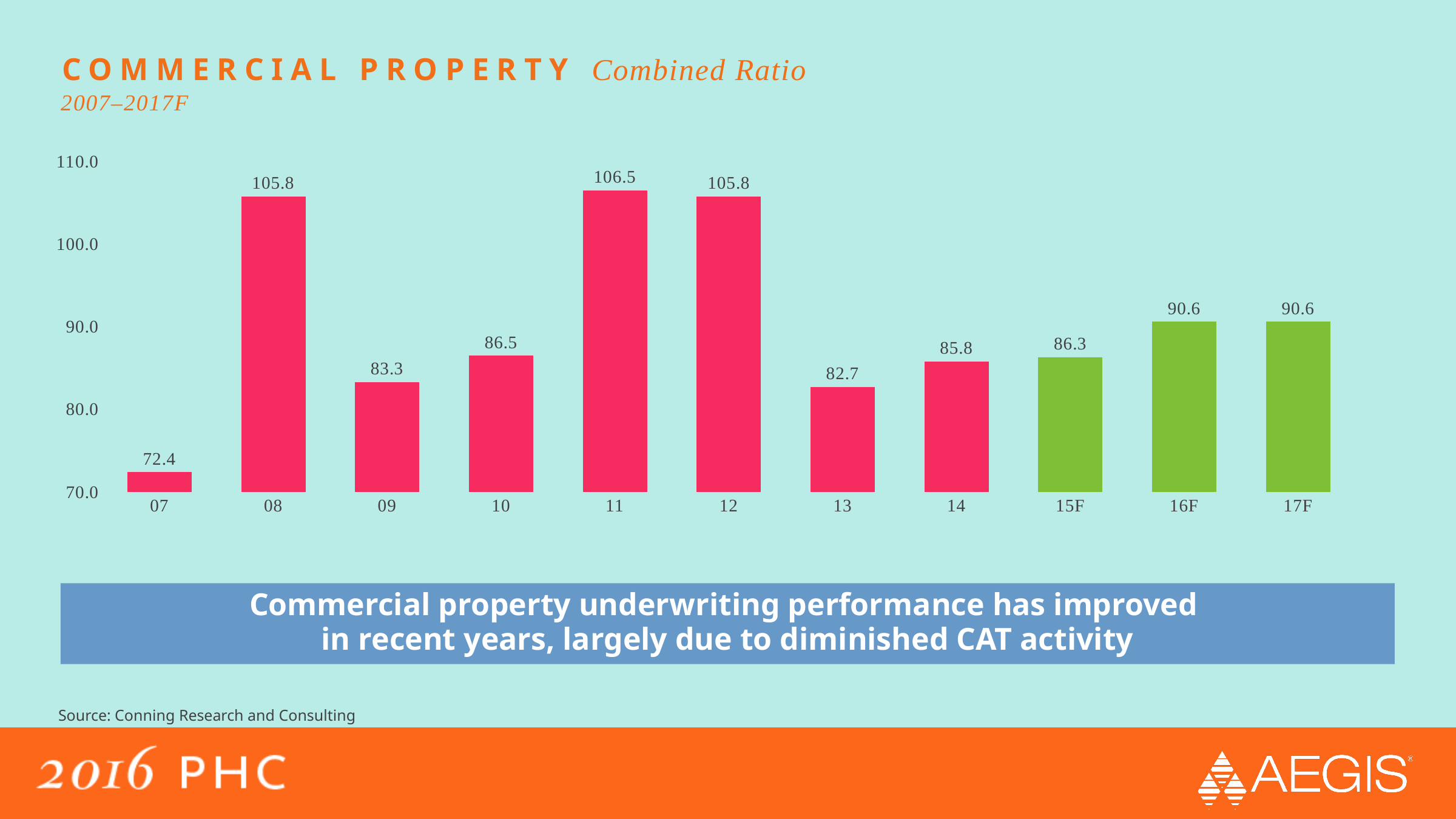
Which is larger, the combined ratio for 10 or for 14? 10 What colour are the bars for the forecast years 15F, 16F and 17F? green What is the difference between the combined ratio in 11 and in 13? 23.8 What kind of chart is shown on the slide? bar chart What is the combined ratio for 07? 72.4 How many years are shown on the x axis? 11 Does the combined ratio rise or fall from 12 to 13? fall Which year has the lowest combined ratio? 07 Which year has the highest combined ratio? 11 Is the combined ratio for 09 greater or less than 80.0? greater What is the combined ratio for 2011? 106.5 What is the forecast combined ratio for 16F? 90.6